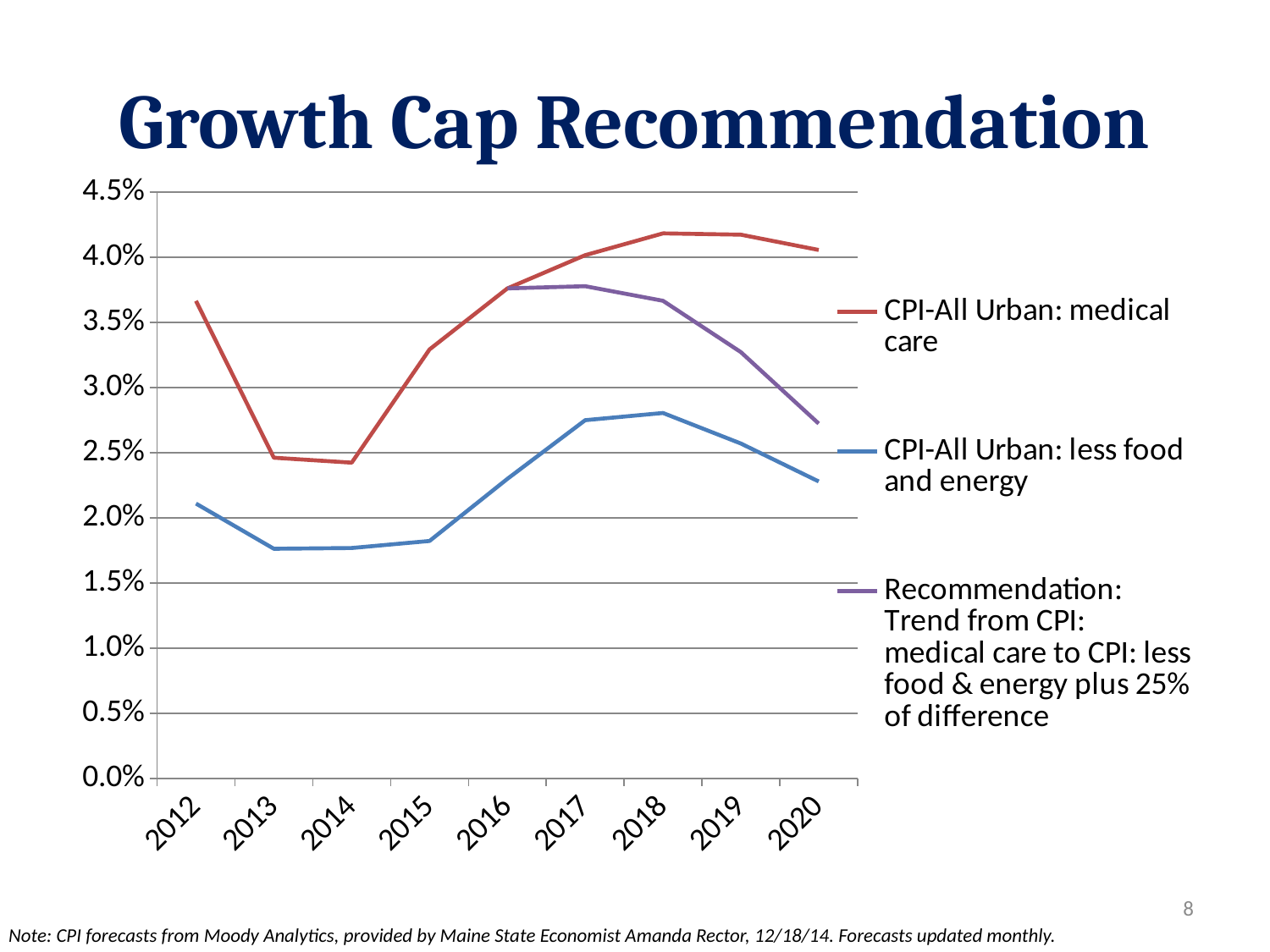
Does the CPI-All Urban: medical care line rise or fall from 2012 to 2014? fall Is the value for CPI-All Urban: less food and energy in 2018 greater or less than 2.5%? greater Is the value for CPI-All Urban: medical care in 2018 greater or less than 4.0%? greater Is the value for CPI-All Urban: less food and energy in 2013 greater or less than 2.0%? less What is the title of the chart? Growth Cap Recommendation In which year is the Recommendation series at its lowest? 2020 In 2020, which is larger: CPI-All Urban: medical care or CPI-All Urban: less food and energy? CPI-All Urban: medical care How many series does the legend list? 3 What kind of chart is shown on the slide? line chart How many years are shown on the x axis? 9